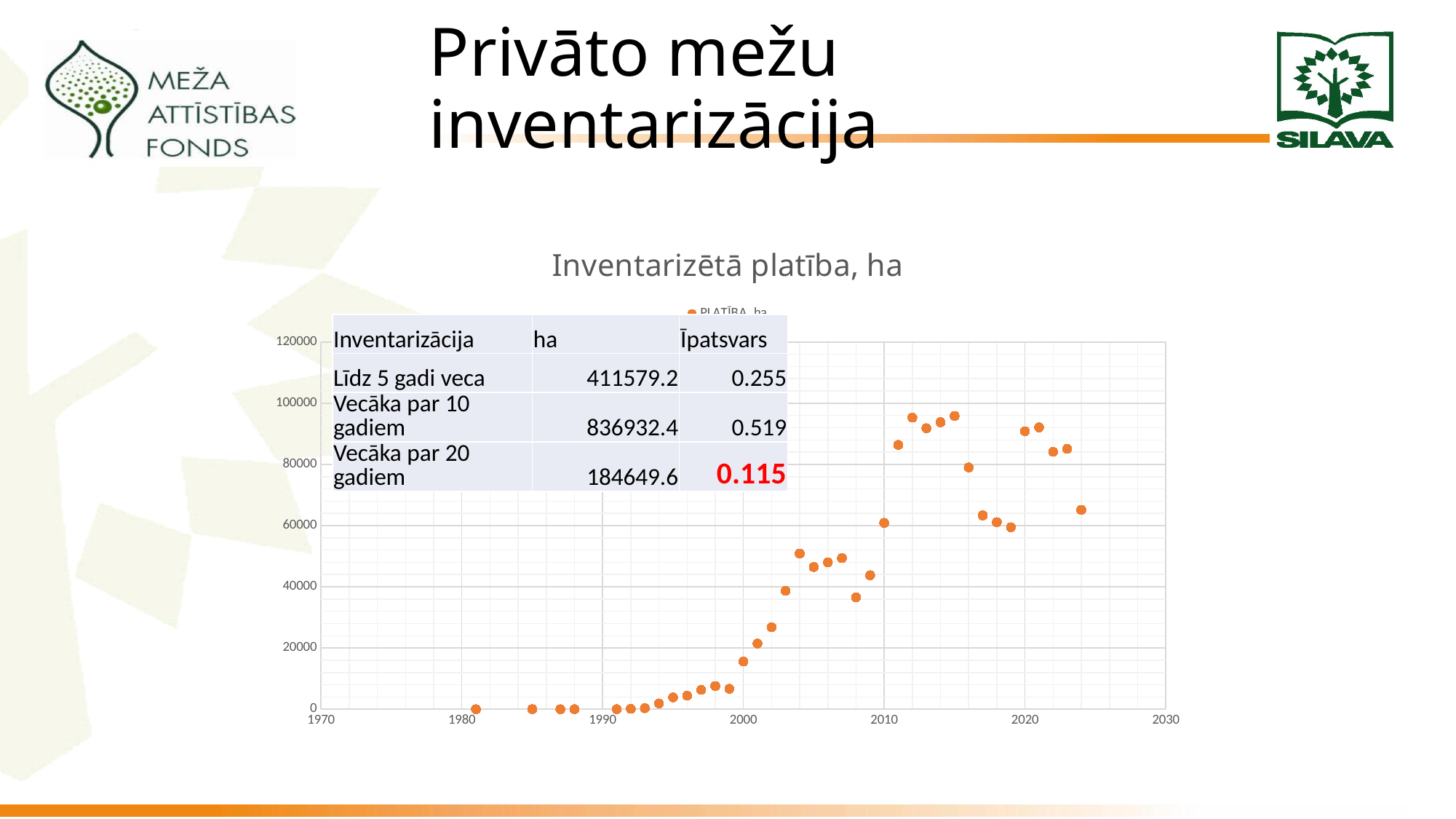
Is the value for 2015 greater or less than 80000? greater What is the title of the chart? Inventarizētā platība, ha Which year has the larger value, 2000 or 2010? 2010 Which year has the larger value, 2005 or 2020? 2020 Is the value for 2024 greater or less than 80000? less What is the highest value shown on the chart's vertical axis? 120000 What kind of chart is shown on the slide? scatter chart How many series does the chart's legend list? 1 Do the values generally rise or fall between 1990 and 2010? rise Is the value for 2000 greater or less than 20000? less